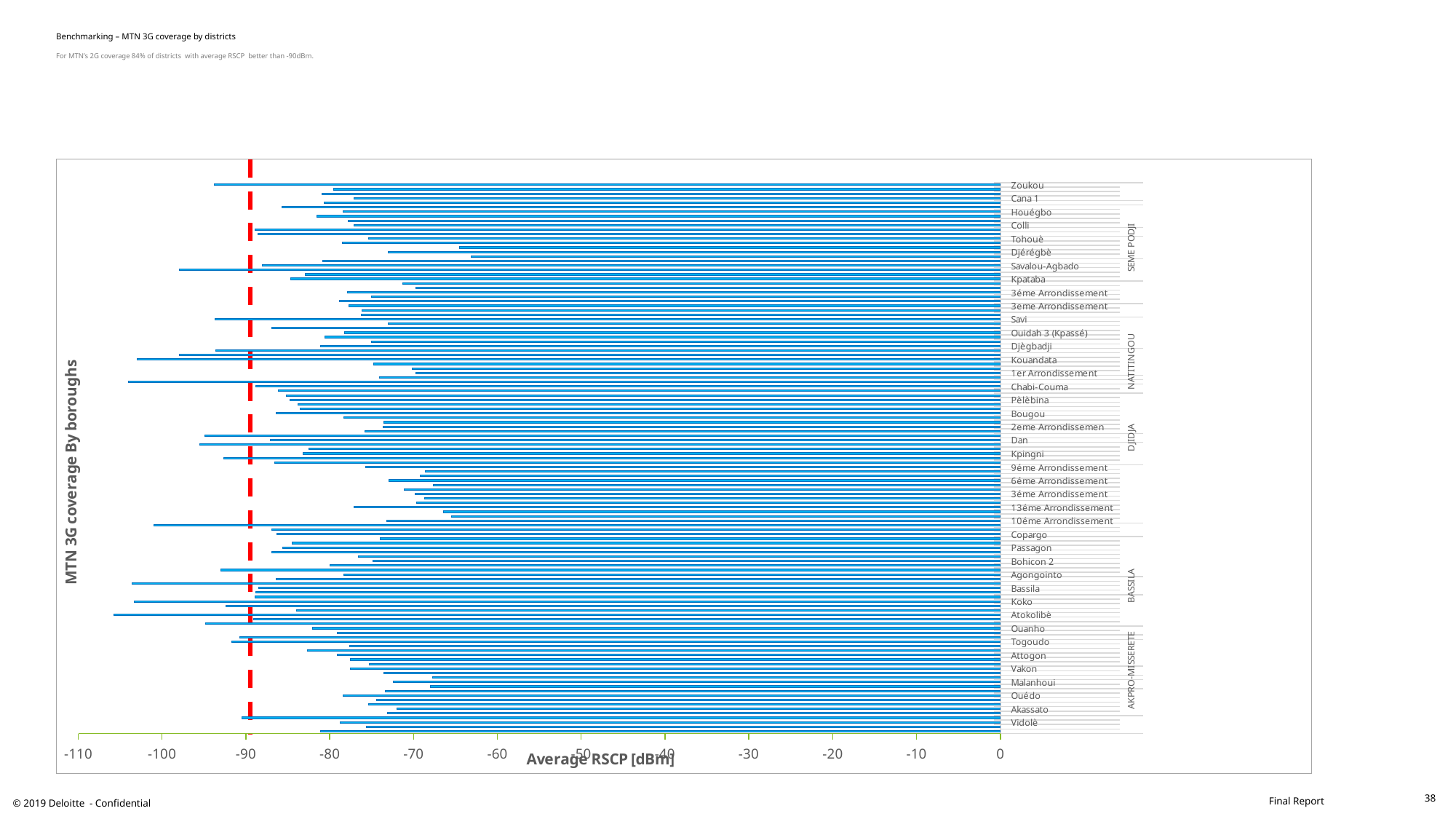
How many borough group labels (such as SEME PODJI and BASSILA) are shown along the right side of the chart? 5 Is the value of the shortest bar greater or less than -60? less Is the value of the longest bar (the lowest average RSCP) greater or less than -100? less Is the value of the shortest bar (the highest average RSCP) greater or less than -70? greater What kind of chart is shown on the slide? bar chart At what x-axis value is the red dashed vertical line drawn? -90 What is the title of the x axis of the chart? Average RSCP [dBm]